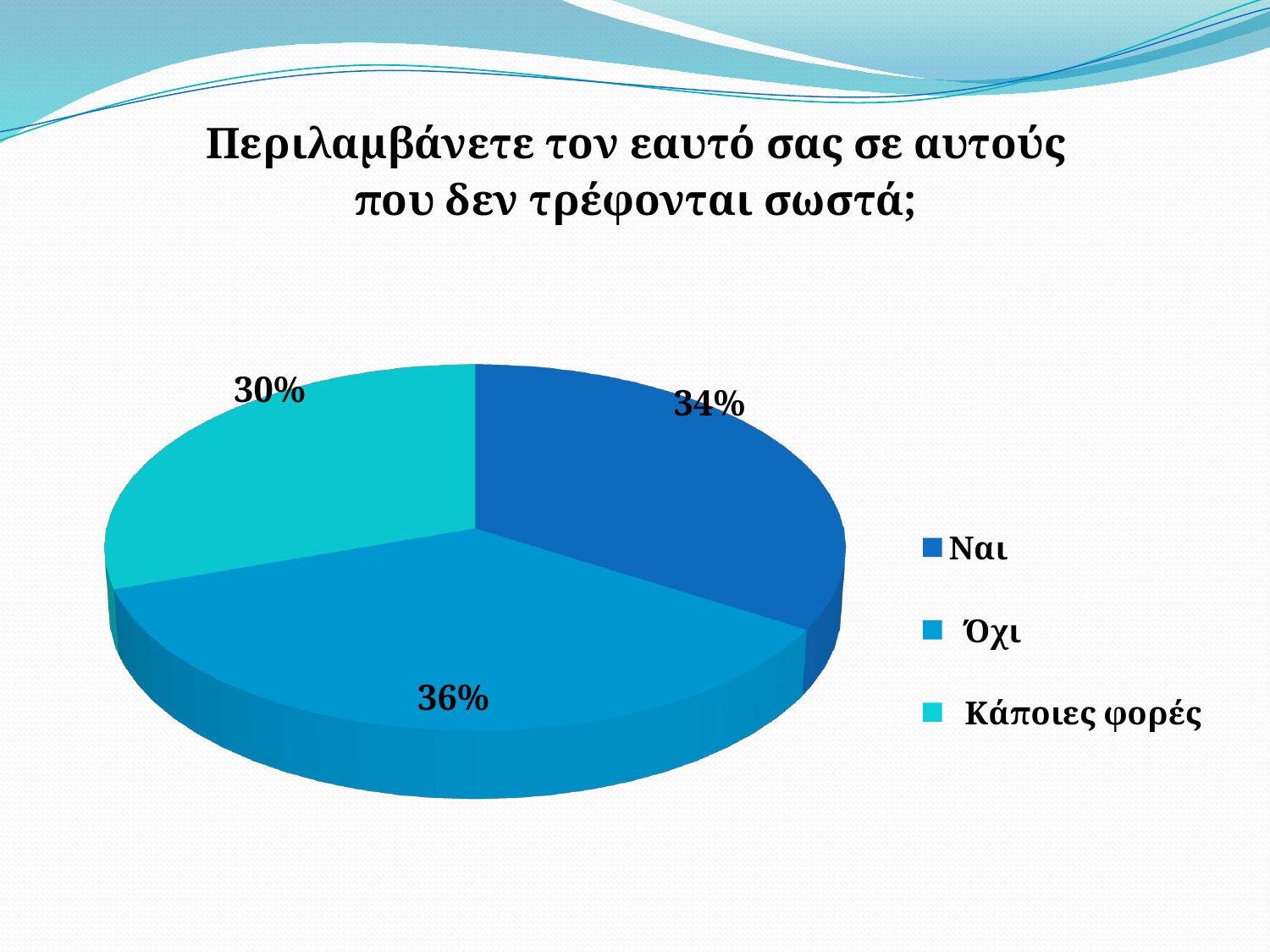
Which category has the smallest share of the pie? Κάποιες φορές What kind of chart is shown on the slide? pie chart Which is larger, the share for "Ναι" or the share for "Όχι"? Όχι What percentage of the pie corresponds to "Κάποιες φορές"? 30% What is the difference in percentage points between "Όχι" and "Κάποιες φορές"? 6 What percentage of the pie corresponds to "Όχι"? 36% What percentage of the pie corresponds to "Ναι"? 34% How many slices does the pie chart have? 3 How many entries does the legend list? 3 What is the title of the chart on the slide? Περιλαμβάνετε τον εαυτό σας σε αυτούς που δεν τρέφονται σωστά; Which category has the largest share of the pie? Όχι What is the difference in percentage points between "Ναι" and "Κάποιες φορές"? 4